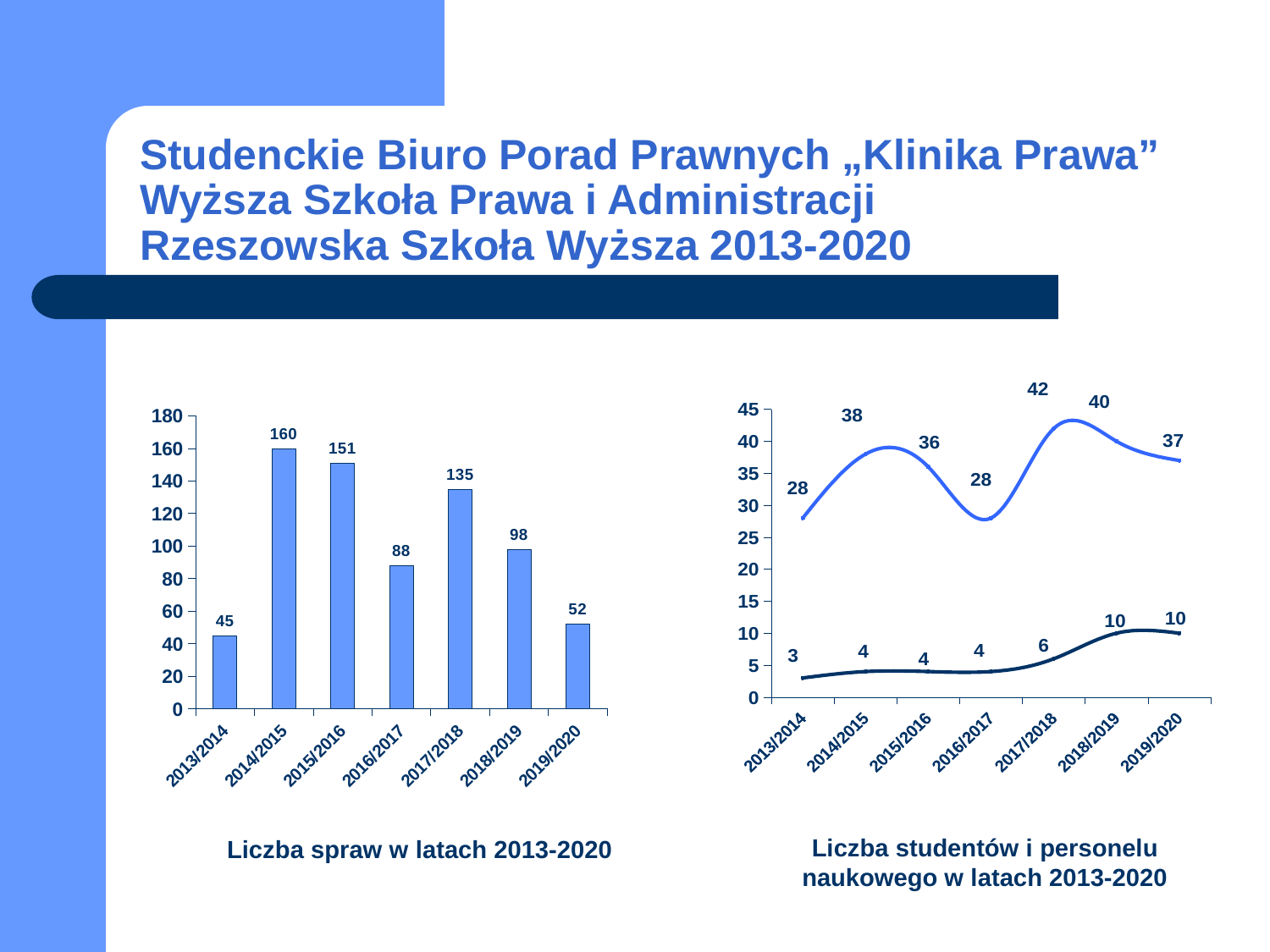
In the left chart (Liczba spraw w latach 2013-2020), what is the value for 2014/2015? 160 In the right chart (Liczba studentów i personelu naukowego w latach 2013-2020), what is the difference between the upper line and the lower line for 2019/2020? 27 In the left chart (Liczba spraw w latach 2013-2020), which year has the lowest value? 2013/2014 What kind of chart is the right chart (Liczba studentów i personelu naukowego w latach 2013-2020)? line chart In the left chart (Liczba spraw w latach 2013-2020), how many years are shown on the x axis? 7 In the left chart (Liczba spraw w latach 2013-2020), which is larger, the value for 2018/2019 or the value for 2019/2020? 2018/2019 What kind of chart is the left chart (Liczba spraw w latach 2013-2020)? bar chart In the right chart (Liczba studentów i personelu naukowego w latach 2013-2020), what is the value of the upper line for 2017/2018? 42 In the right chart (Liczba studentów i personelu naukowego w latach 2013-2020), does the lower line rise or fall from 2013/2014 to 2018/2019? rise In the left chart (Liczba spraw w latach 2013-2020), what is the difference between the values for 2017/2018 and 2016/2017? 47 In the left chart (Liczba spraw w latach 2013-2020), which year has the highest value? 2014/2015 In the right chart (Liczba studentów i personelu naukowego w latach 2013-2020), what is the value of the lower line for 2013/2014? 3